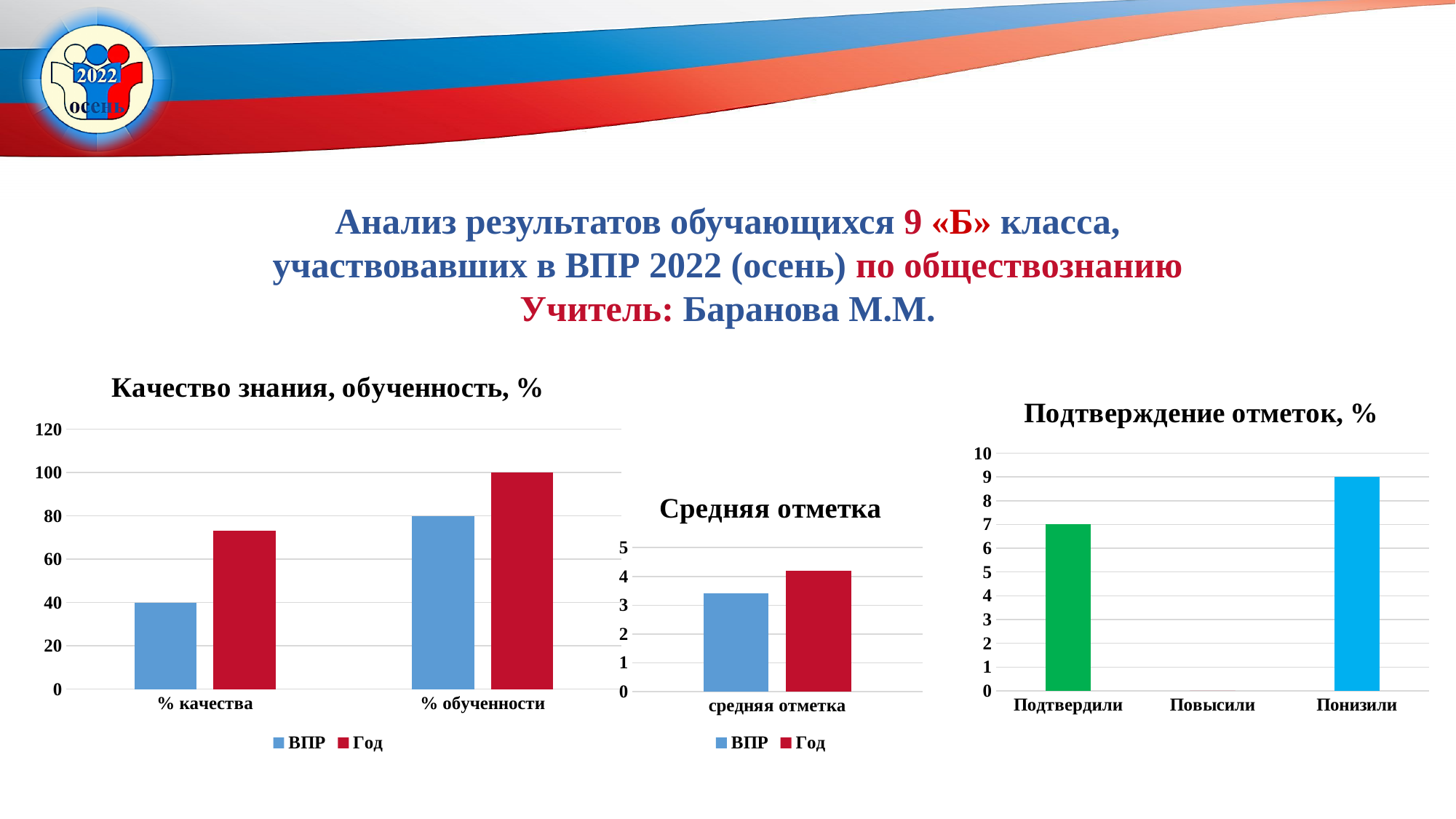
In the chart "Качество знания, обученность, %", is the value of Год for "% качества" greater or less than 60? greater In the chart "Подтверждение отметок, %", which category has the highest value? Понизили In the chart "Качество знания, обученность, %", what is the value of ВПР for "% обученности"? 80 In the chart "Качество знания, обученность, %", what is the value of Год for "% обученности"? 100 In the chart "Качество знания, обученность, %", which series has the larger value for "% качества", ВПР or Год? Год In the chart "Средняя отметка", is the value of ВПР greater or less than 4? less In the chart "Подтверждение отметок, %", what is the value for "Подтвердили"? 7 In the chart "Средняя отметка", which series has the larger value, ВПР or Год? Год In the chart "Подтверждение отметок, %", how many categories are shown on the x axis? 3 In the chart "Качество знания, обученность, %", how many series does the legend list? 2 In the chart "Качество знания, обученность, %", what is the value of ВПР for "% качества"? 40 What type of chart is "Качество знания, обученность, %"? bar chart